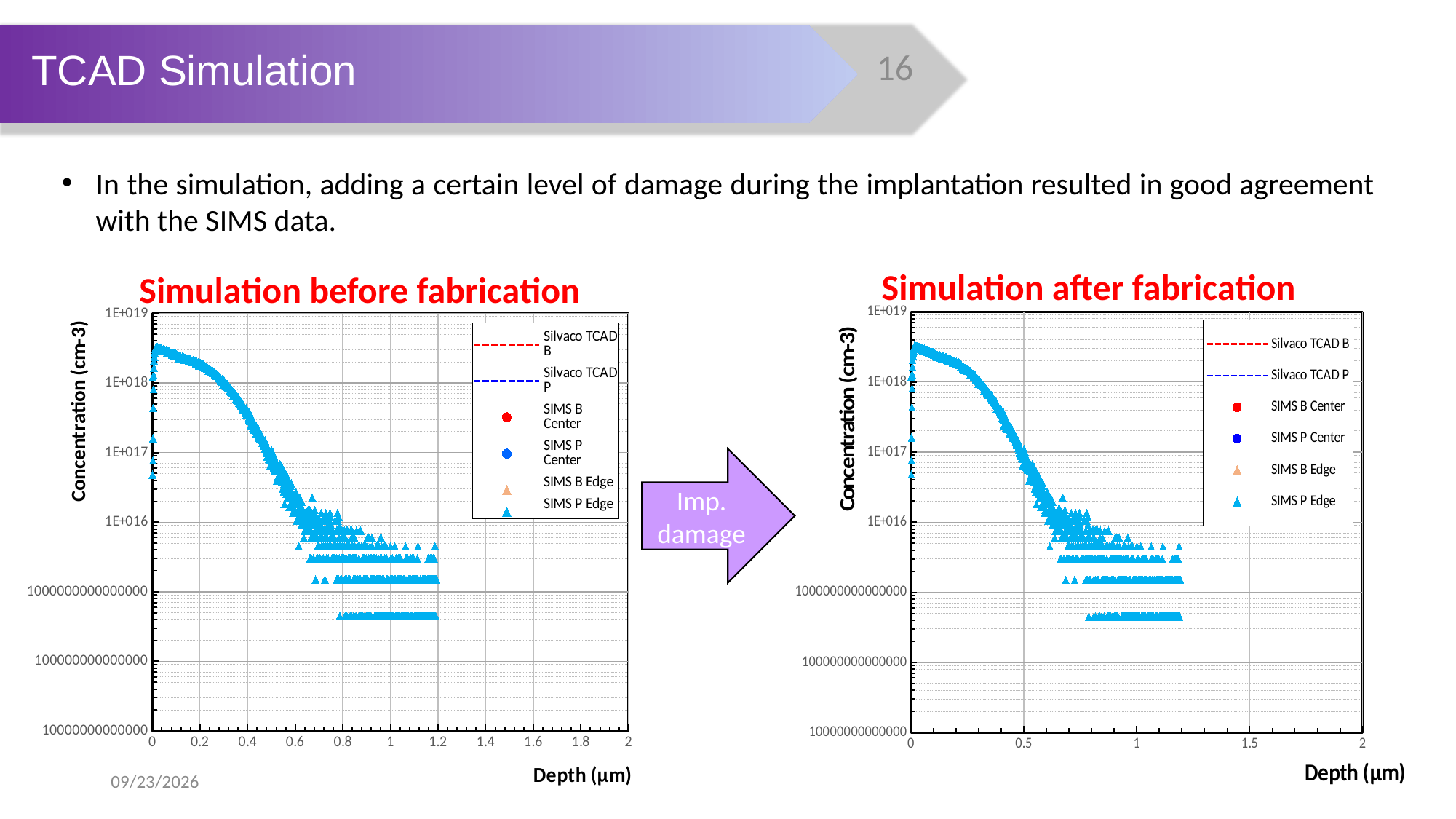
In the 'Simulation before fabrication' chart, does the plotted concentration rise or fall as depth increases? fall Which legend entry in the 'Simulation after fabrication' chart is shown with light blue triangle markers? SIMS P Edge How many series does the legend of the 'Simulation before fabrication' chart list? 6 How many series does the legend of the 'Simulation after fabrication' chart list? 6 In the 'Simulation before fabrication' chart, is the peak concentration of the plotted data greater or less than 1E+018? greater What is the maximum value shown on the x axis of the 'Simulation after fabrication' chart? 2 In the 'Simulation after fabrication' chart, does the plotted concentration rise or fall as depth increases? fall In the 'Simulation before fabrication' chart, is the concentration at a depth of 0.4 µm greater or less than 1E+016? greater What is the x-axis label of the 'Simulation after fabrication' chart? Depth (µm) What is the y-axis label of the 'Simulation before fabrication' chart? Concentration (cm-3) What kind of chart is the 'Simulation before fabrication' chart? scatter chart In the 'Simulation after fabrication' chart, is the concentration at a depth of 1 µm greater or less than 1E+016? less